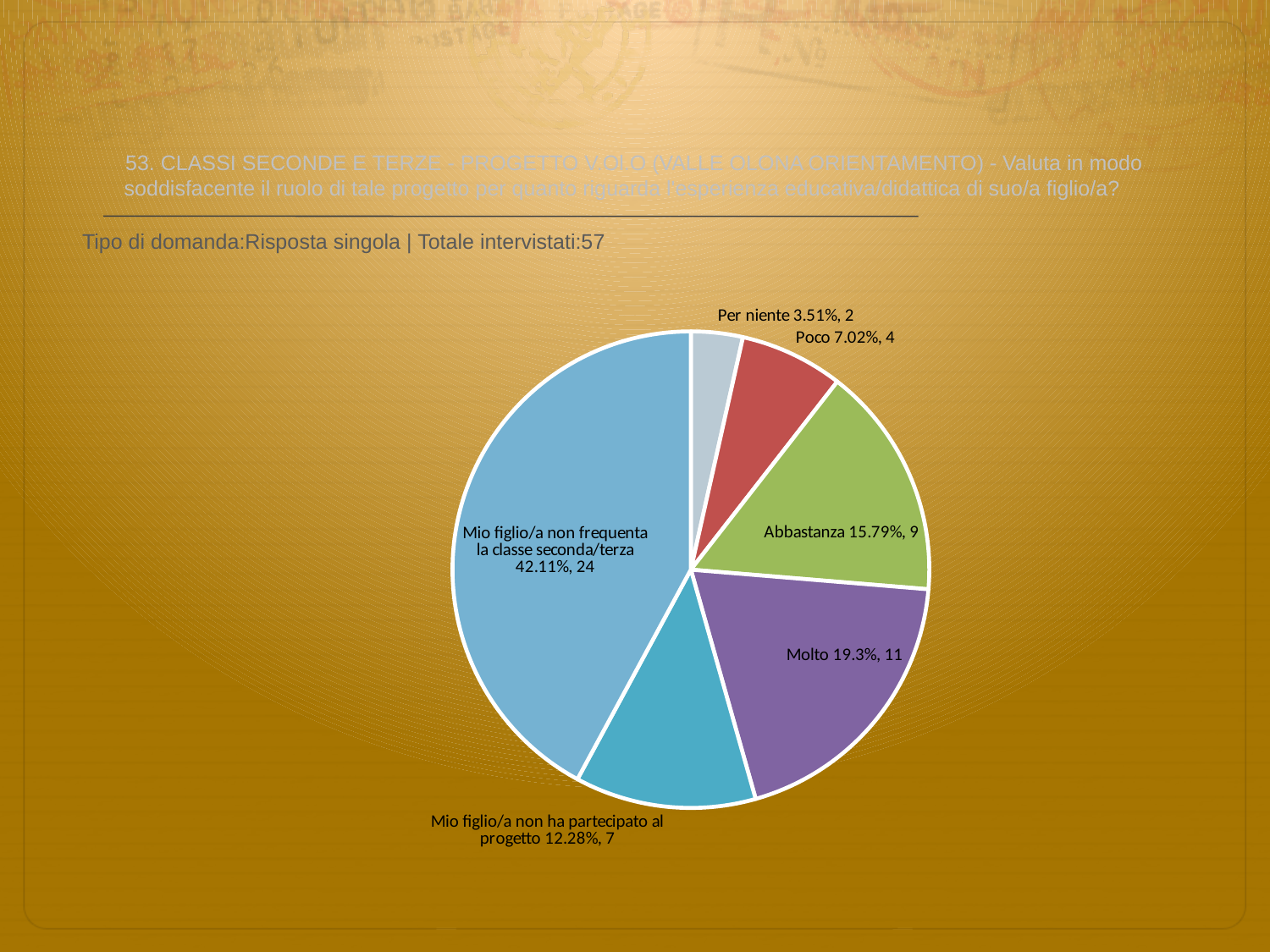
How many slices does the pie chart have? 6 What percentage share does 'Mio figlio/a non ha partecipato al progetto' have? 12.28% Which has a larger count, 'Poco' or 'Per niente'? Poco What is the difference in count between 'Molto' and 'Abbastanza'? 2 Which category has the smallest slice of the pie? Per niente What is the difference in count between 'Mio figlio/a non frequenta la classe seconda/terza' and 'Mio figlio/a non ha partecipato al progetto'? 17 What kind of chart is shown on the slide? pie chart Which category has the largest slice of the pie? Mio figlio/a non frequenta la classe seconda/terza What is the count for 'Poco'? 4 How many respondents answered 'Abbastanza'? 9 What is the total number of respondents shown on the slide? 57 What percentage share does the 'Molto' slice have? 19.3%